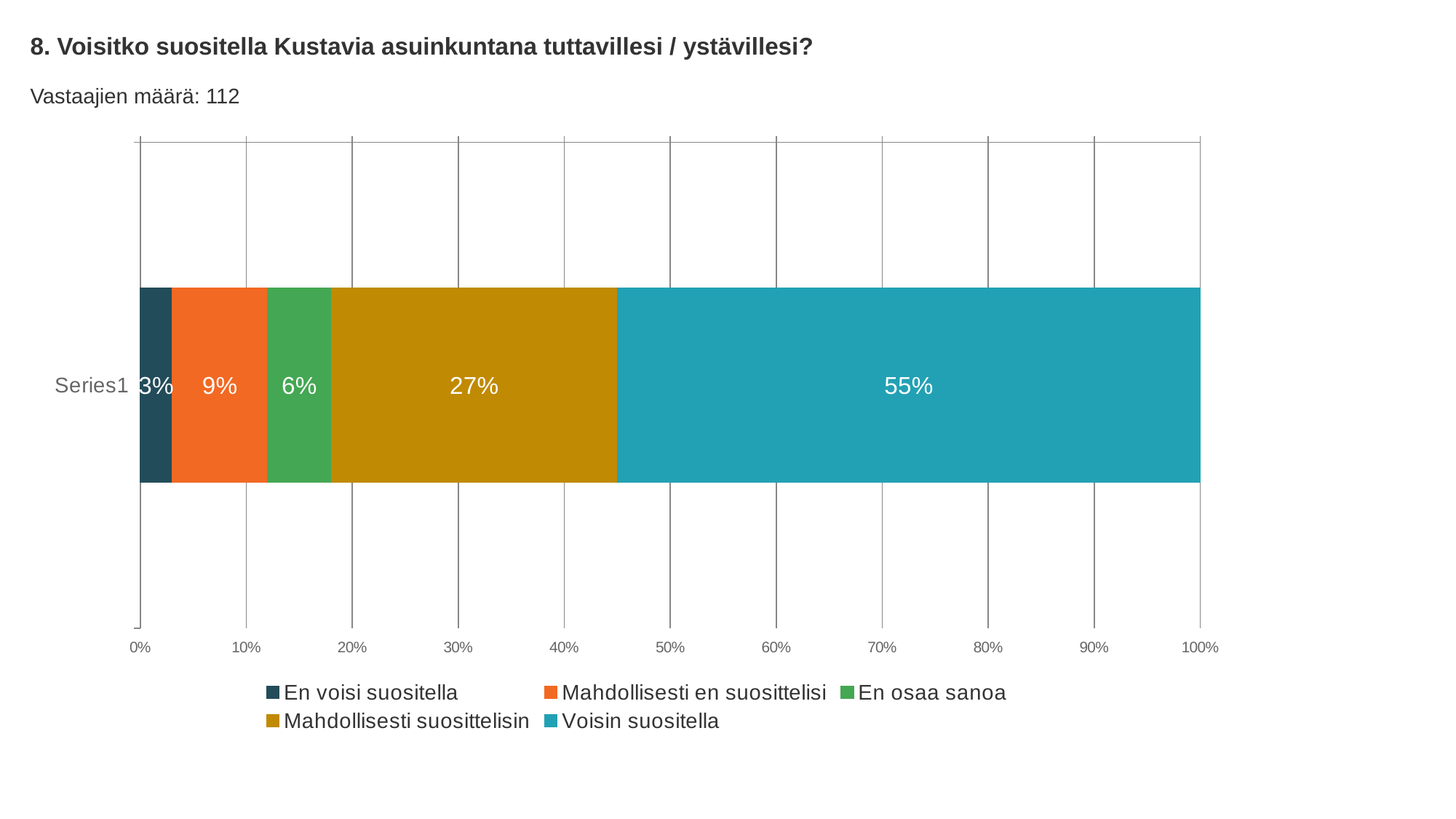
What percentage of respondents answered "Voisin suositella"? 55% What is the difference in percentage points between "Voisin suositella" and "Mahdollisesti suosittelisin"? 28 Which response option has the largest share? Voisin suositella What is the total of the stacked bar? 100% What percentage of respondents answered "En osaa sanoa"? 6% Which response option has the smallest share? En voisi suositella What percentage of respondents answered "Mahdollisesti suosittelisin"? 27% Which is larger, the share for "Mahdollisesti en suosittelisi" or for "En osaa sanoa"? Mahdollisesti en suosittelisi How many series does the legend list? 5 How many respondents (Vastaajien määrä) are reported on the slide? 112 What kind of chart is shown on the slide? Stacked bar chart What percentage of respondents answered "En voisi suositella"? 3%